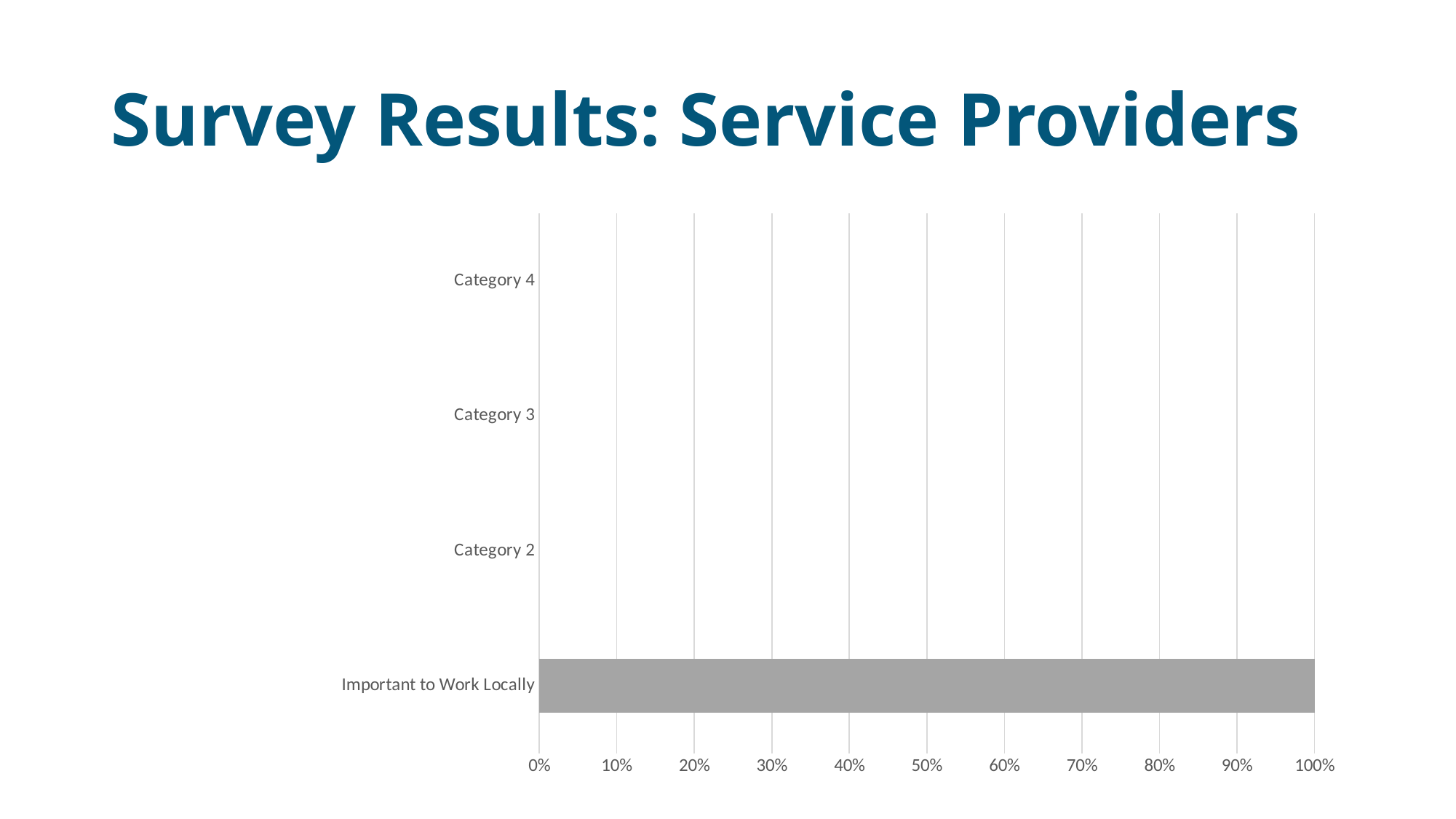
Which category is listed at the top of the vertical axis? Category 4 What is the maximum value shown on the horizontal axis of the chart? 100% Which category is the only one with a visible bar in the chart? Important to Work Locally Is the value for Important to Work Locally greater or less than 90%? greater What is the value for Important to Work Locally? 100% What kind of chart is shown on the slide? bar chart What is the title of the slide? Survey Results: Service Providers Which category has the highest value in the chart? Important to Work Locally Is the value for Important to Work Locally greater or less than 50%? greater How many categories are listed on the vertical axis of the chart? 4